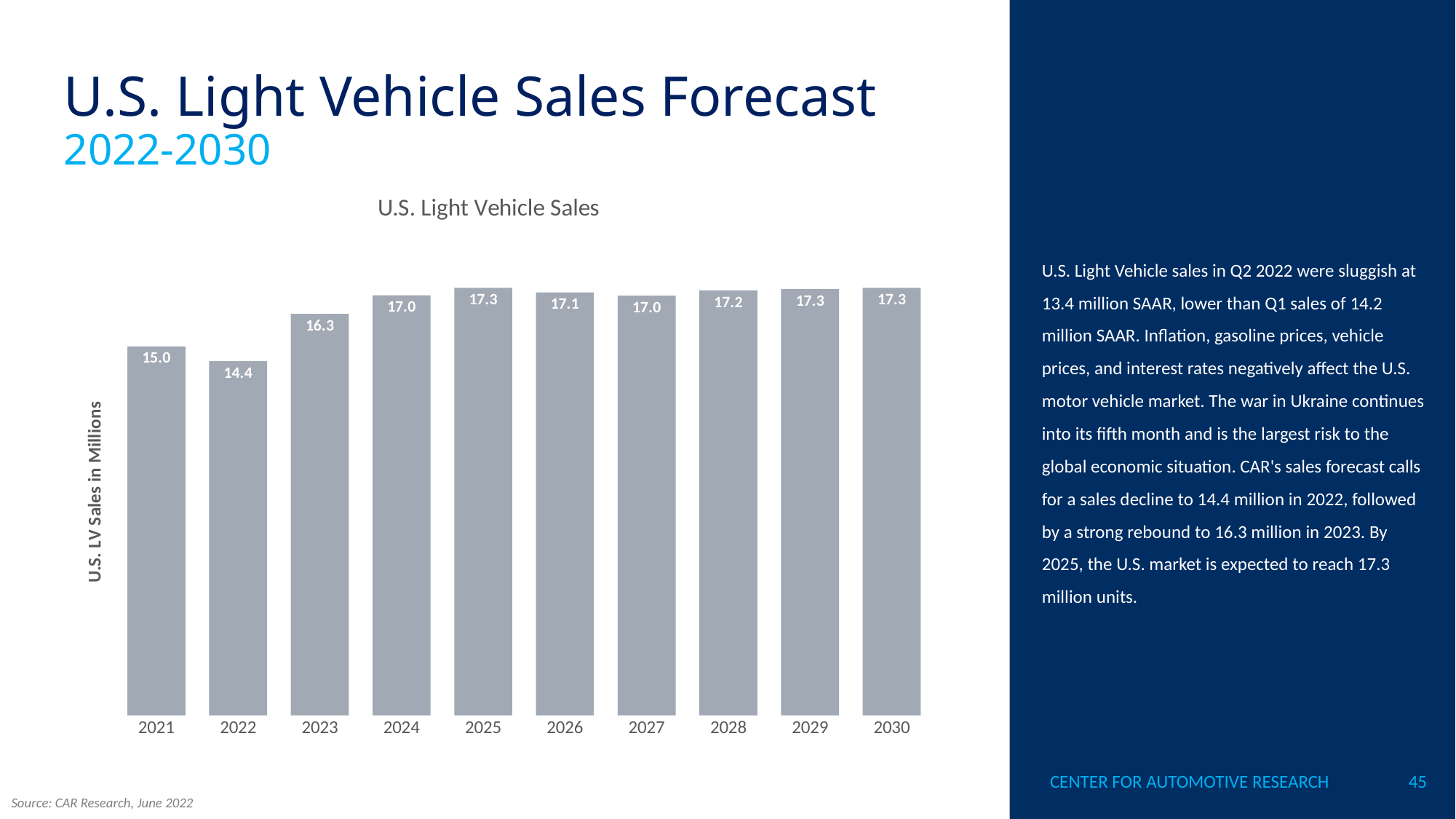
Which year has the lowest U.S. light vehicle sales value? 2022 Which is larger, the value for 2021 or the value for 2022? 2021 What kind of chart is shown on the slide? Bar chart What is the difference between the 2025 and 2021 values? 2.3 Which is larger, the value for 2024 or the value for 2025? 2025 What is the y-axis label of the chart? U.S. LV Sales in Millions What is the U.S. light vehicle sales value for 2028? 17.2 What is the U.S. light vehicle sales value for 2022? 14.4 What is the U.S. light vehicle sales value for 2021? 15.0 What is the difference between the 2023 and 2022 values? 1.9 How many years are shown on the x axis of the chart? 10 What is the U.S. light vehicle sales value for 2023? 16.3